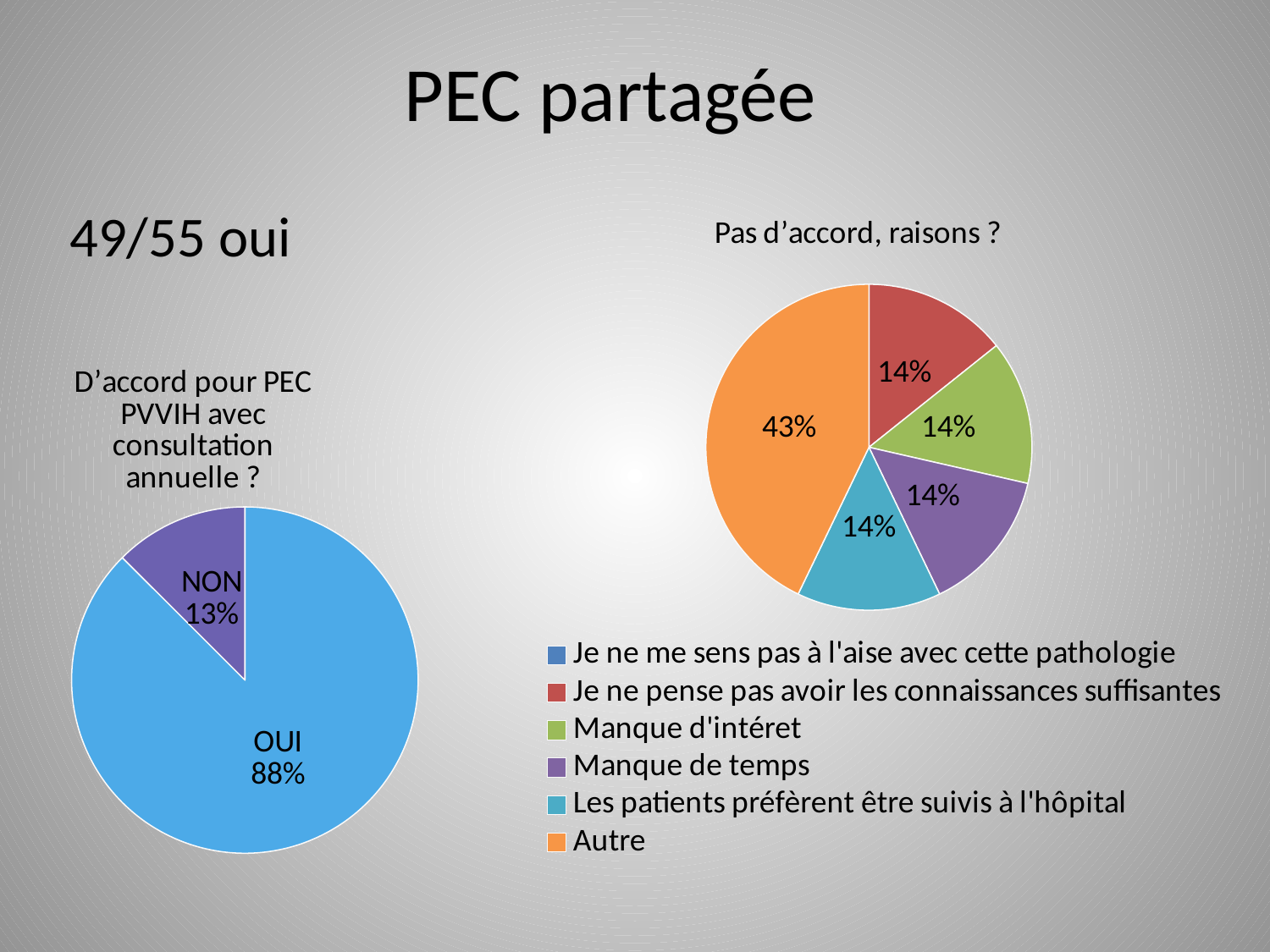
On the left chart (D'accord pour PEC PVVIH avec consultation annuelle ?), what percentage is shown for NON? 13% On the left chart (D'accord pour PEC PVVIH avec consultation annuelle ?), what is the difference in percentage points between OUI and NON? 75 What colour is the Autre slice on the right chart (Pas d'accord, raisons ?)? Orange On the right chart (Pas d'accord, raisons ?), what percentage is shown for Autre? 43% What kind of chart is the left chart (D'accord pour PEC PVVIH avec consultation annuelle ?)? Pie chart How many entries does the legend of the right chart (Pas d'accord, raisons ?) list? 6 On the right chart (Pas d'accord, raisons ?), what percentage is shown for Manque de temps? 14% On the left chart (D'accord pour PEC PVVIH avec consultation annuelle ?), which slice is the largest? OUI On the right chart (Pas d'accord, raisons ?), what is the difference in percentage points between Autre and Les patients préfèrent être suivis à l'hôpital? 29 On the right chart (Pas d'accord, raisons ?), which reason has the largest slice? Autre On the right chart (Pas d'accord, raisons ?), which is larger: Autre or Manque d'intéret? Autre On the left chart (D'accord pour PEC PVVIH avec consultation annuelle ?), what percentage is shown for OUI? 88%